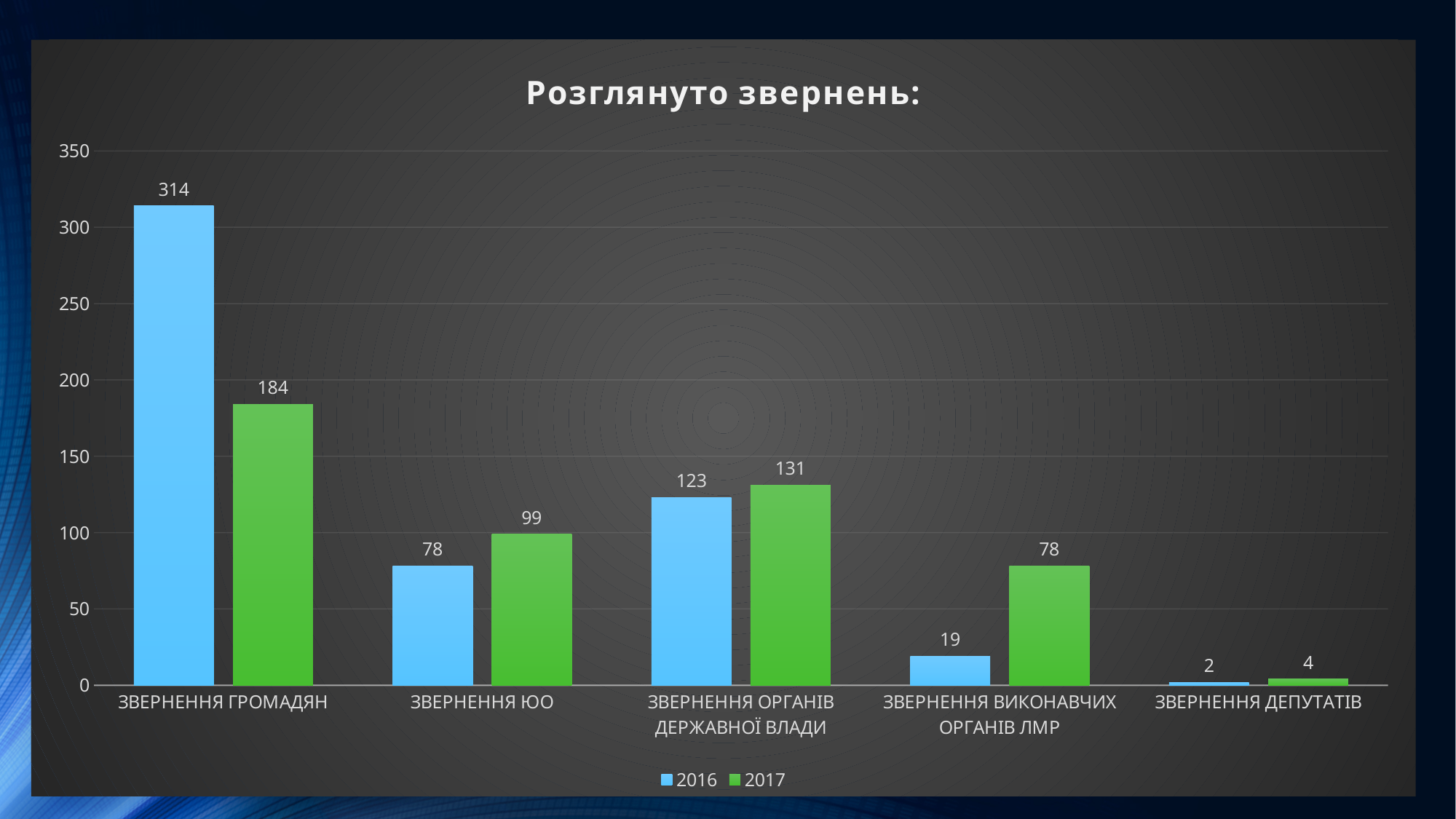
What is the 2017 value for ЗВЕРНЕННЯ ЮО? 99 What is the 2017 value for ЗВЕРНЕННЯ ВИКОНАВЧИХ ОРГАНІВ ЛМР? 78 Which category has the highest 2016 value? ЗВЕРНЕННЯ ГРОМАДЯН What is the difference between the 2017 and 2016 values for ЗВЕРНЕННЯ ВИКОНАВЧИХ ОРГАНІВ ЛМР? 59 What is the 2016 value for ЗВЕРНЕННЯ ГРОМАДЯН? 314 What is the title of the chart? Розглянуто звернень: What kind of chart is shown on the slide? bar chart What is the difference between the 2016 and 2017 values for ЗВЕРНЕННЯ ГРОМАДЯН? 130 How many categories are shown on the x axis? 5 Which category has the lowest 2017 value? ЗВЕРНЕННЯ ДЕПУТАТІВ Which is larger for ЗВЕРНЕННЯ ОРГАНІВ ДЕРЖАВНОЇ ВЛАДИ: the 2016 value or the 2017 value? 2017 How many series does the legend list? 2